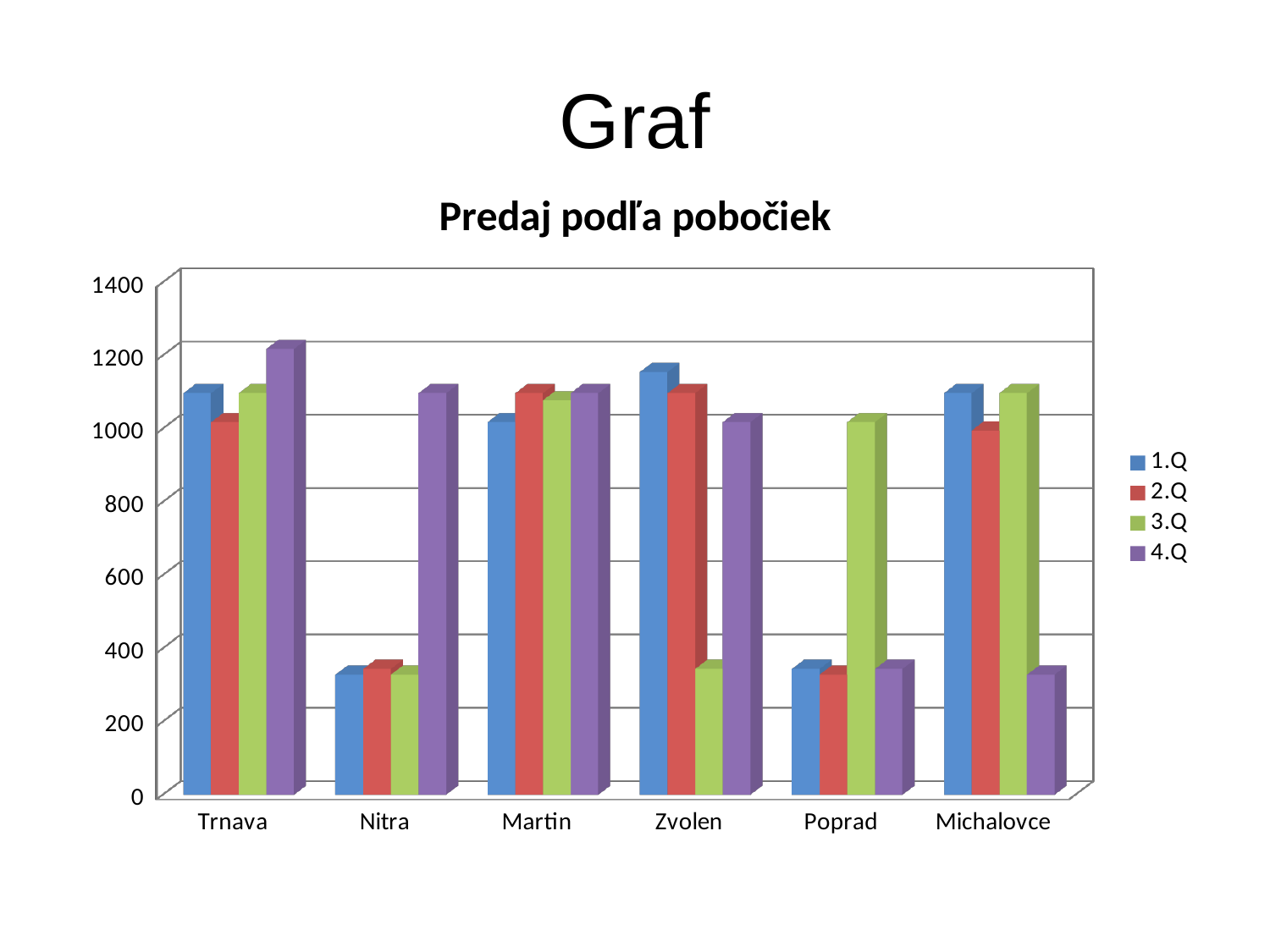
How many branches (categories) are shown on the x axis? 6 Which series has the highest value for Poprad? 3.Q Is the 1.Q value for Nitra greater or less than 400? less What is the title of the chart? Predaj podľa pobočiek Which series has the lowest value for Zvolen? 3.Q Is the 3.Q value for Poprad greater or less than 800? greater What type of chart is shown on the slide? bar chart Which series has the highest value for Nitra? 4.Q For Zvolen, which is larger: the 1.Q value or the 3.Q value? 1.Q Which series has the lowest value for Michalovce? 4.Q How many series does the legend list? 4 Is the 1.Q value for Zvolen greater or less than 1000? greater